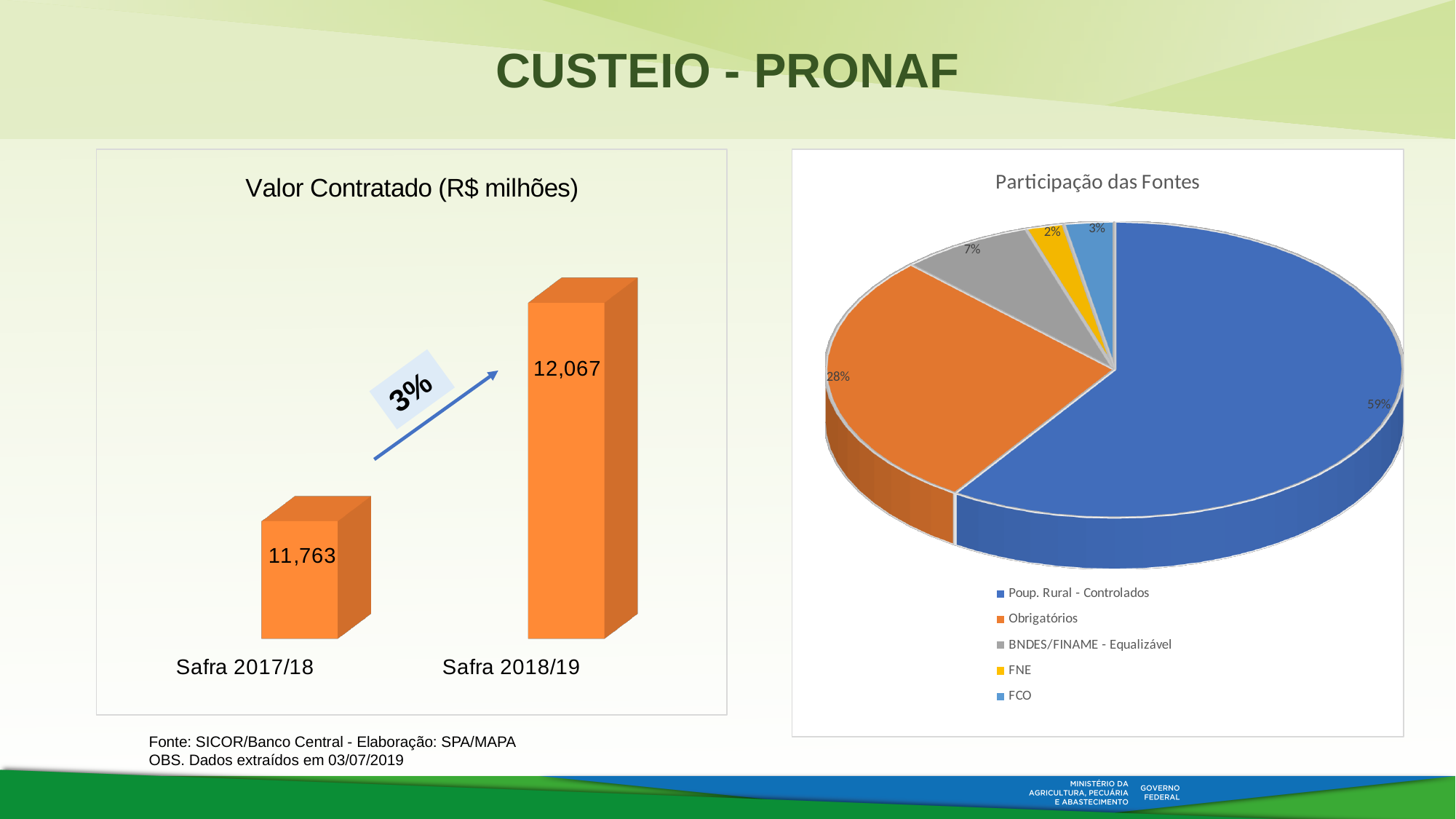
In the 'Participação das Fontes' chart, what share does BNDES/FINAME - Equalizável have? 7% In the 'Participação das Fontes' chart, what share does Poup. Rural - Controlados have? 59% In the 'Participação das Fontes' chart, which source has the smallest share? FNE What kind of chart is 'Valor Contratado (R$ milhões)'? Bar chart In the 'Valor Contratado (R$ milhões)' chart, what is the difference between Safra 2018/19 and Safra 2017/18? 304 In the 'Valor Contratado (R$ milhões)' chart, which safra has the higher value? Safra 2018/19 What kind of chart is 'Participação das Fontes'? Pie chart In the 'Participação das Fontes' chart, what share does Obrigatórios have? 28% How many sources are listed in the legend of the 'Participação das Fontes' chart? 5 In the 'Valor Contratado (R$ milhões)' chart, what is the value for Safra 2018/19? 12,067 In the 'Valor Contratado (R$ milhões)' chart, what percentage change is shown between the two safras? 3% In the 'Valor Contratado (R$ milhões)' chart, what is the value for Safra 2017/18? 11,763